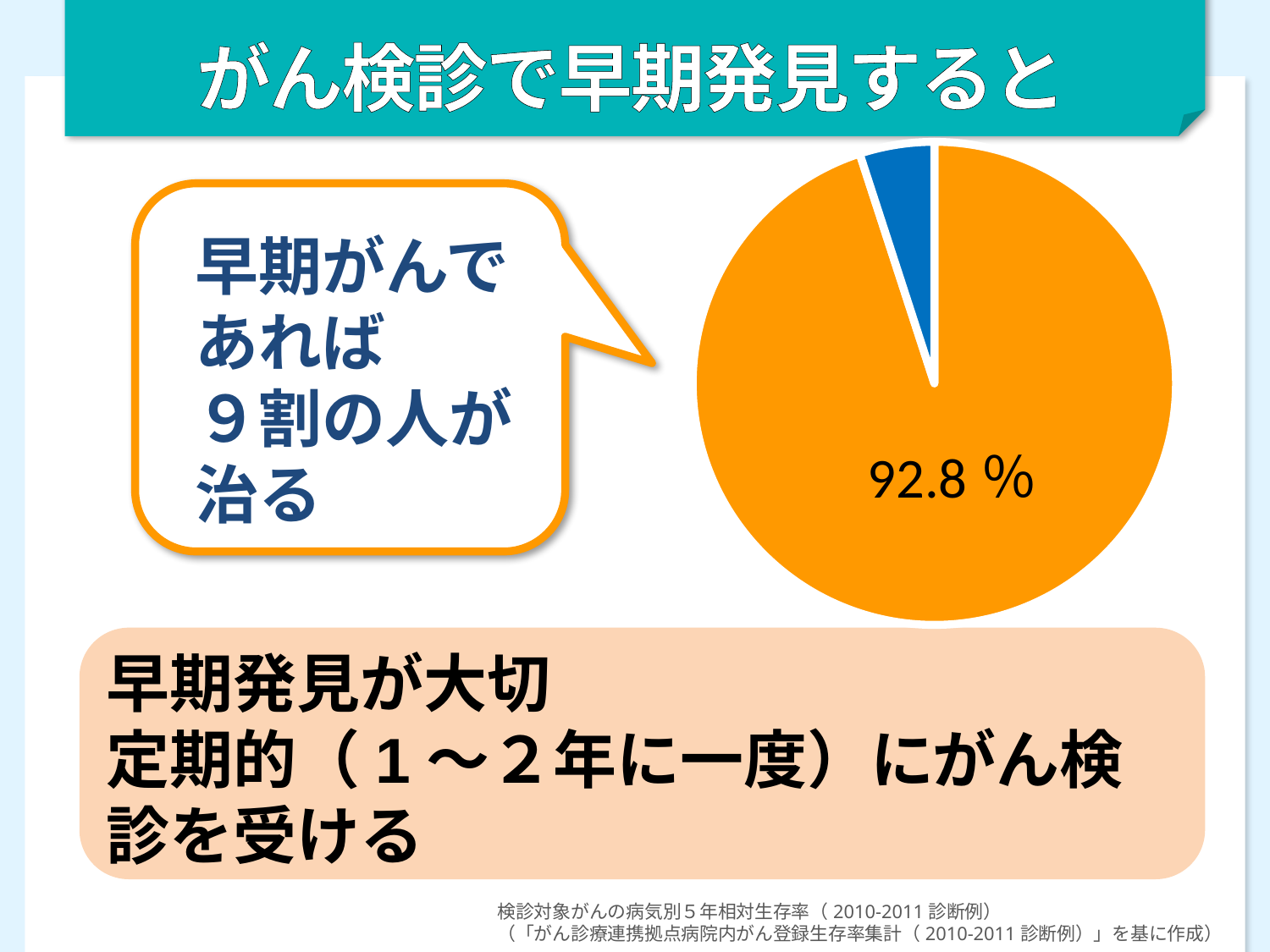
What kind of chart is shown on the slide? pie chart What value is printed on the orange slice of the pie chart? 92.8 % How many slices does the pie chart have? 2 What colour is the largest slice of the pie chart? orange Which slice of the pie chart is larger, the orange one or the blue one? the orange one Does the pie chart show a legend? no Which slice of the pie chart is the smallest? the blue slice What share of the pie does the orange slice represent? 92.8 %